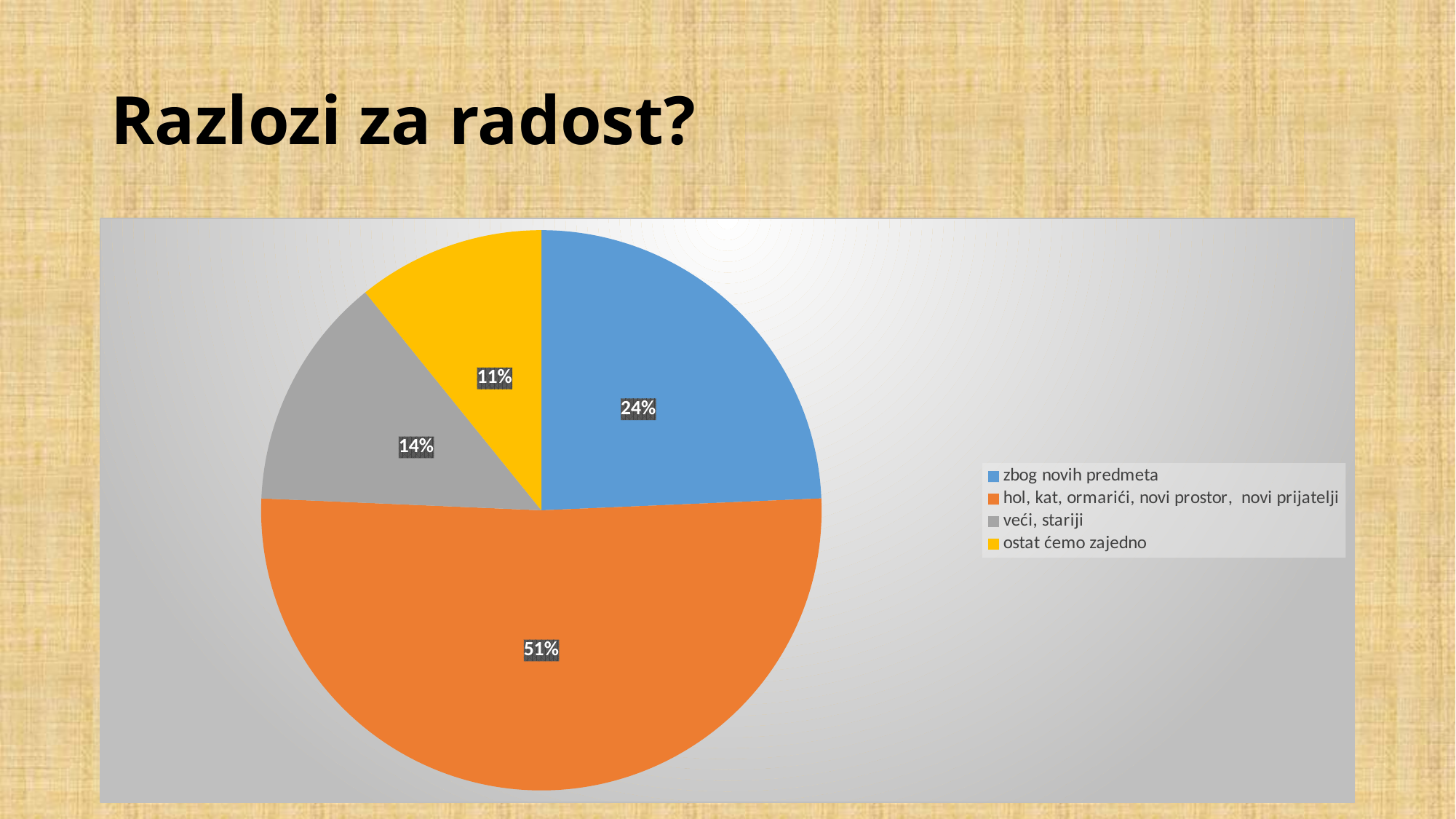
What percentage is shown for "veći, stariji"? 14% What colour is the slice for "zbog novih predmeta"? blue What kind of chart is shown on the slide? pie chart Which category has the smallest slice of the pie? ostat ćemo zajedno What percentage is shown for "ostat ćemo zajedno"? 11% How many categories does the pie chart have? 4 Which is larger, the slice for "veći, stariji" or the slice for "ostat ćemo zajedno"? veći, stariji What is the title of the slide containing the chart? Razlozi za radost? Which category has the largest slice of the pie? hol, kat, ormarići, novi prostor, novi prijatelji What percentage is shown for "hol, kat, ormarići, novi prostor, novi prijatelji"? 51% What is the difference in percentage points between "hol, kat, ormarići, novi prostor, novi prijatelji" and "zbog novih predmeta"? 27 What percentage is shown for "zbog novih predmeta"? 24%